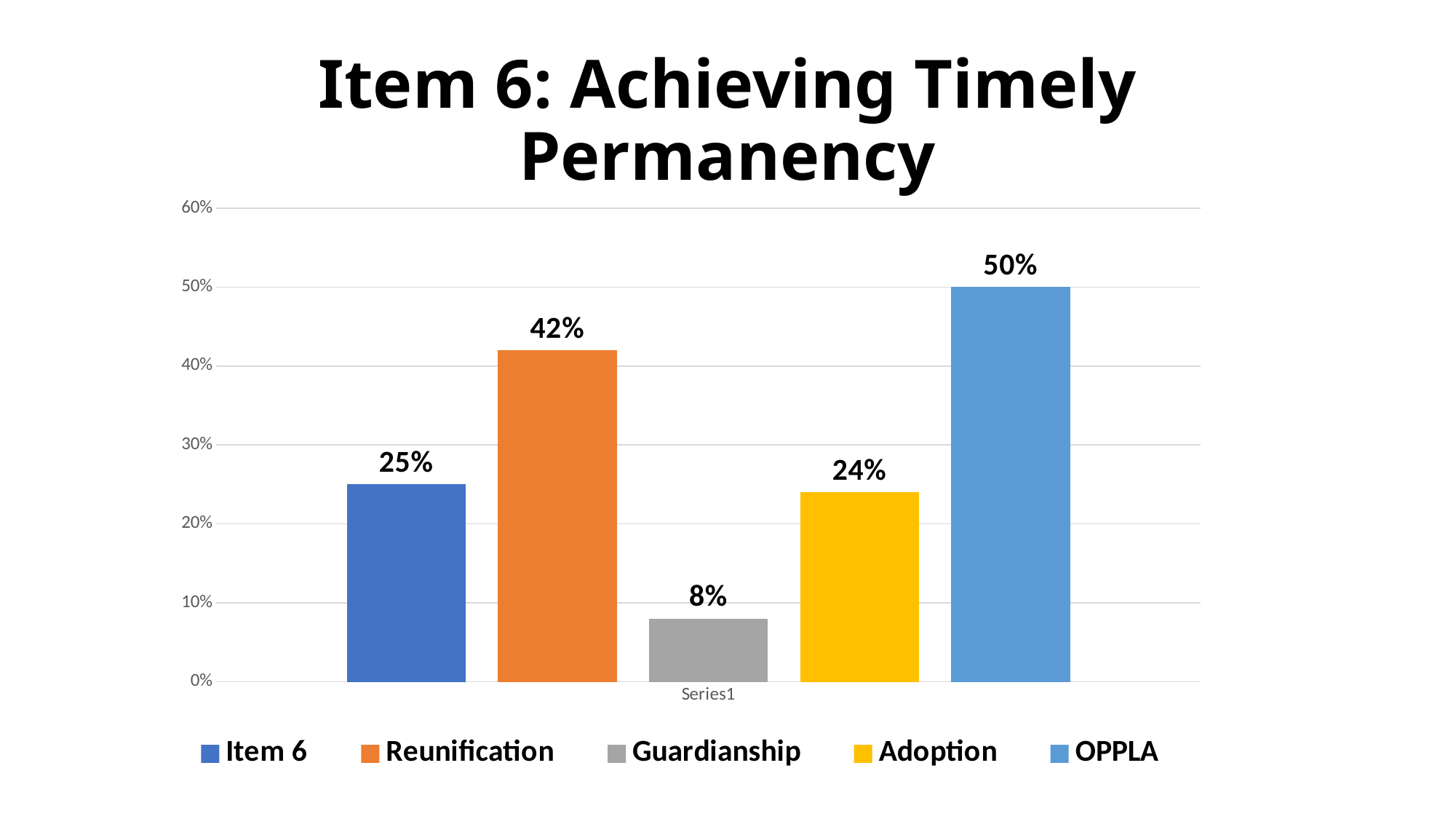
What is the value for Guardianship? 8% Which series has the lowest value? Guardianship What is the difference between the OPPLA value and the Reunification value? 8% What is the title of the chart? Item 6: Achieving Timely Permanency Which series has the highest value? OPPLA What is the difference between the Adoption value and the Guardianship value? 16% What is the value for Item 6? 25% What kind of chart is shown on the slide? Bar chart How many series does the legend list? 5 What is the value for Reunification? 42% Which is larger, the value for Reunification or the value for Adoption? Reunification What is the value for OPPLA? 50%